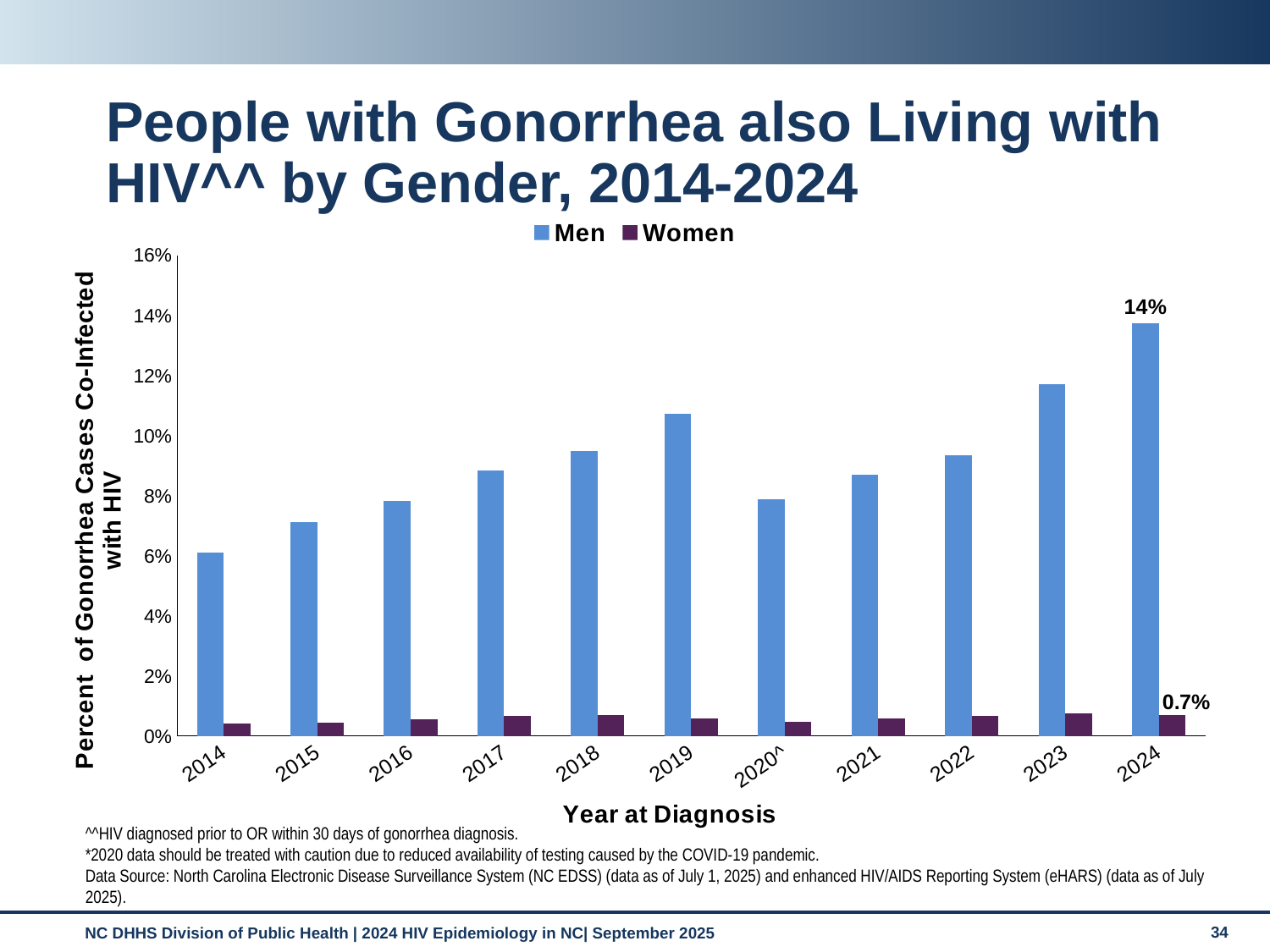
What is the difference between the Men and Women values in 2024? 13.3% How many years are shown on the x axis? 11 How many series does the legend list? 2 What percent of women with gonorrhea were co-infected with HIV in 2024? 0.7% Is the Men value for 2014 greater or less than 8%? less Is the Men value for 2023 greater or less than 10%? greater Do the Men values rise or fall from 2020^ to 2024? rise What percent of men with gonorrhea were co-infected with HIV in 2024? 14% Which year has a higher Men value, 2019 or 2020^? 2019 In which year is the Men bar highest? 2024 What kind of chart is shown on the slide? bar chart In which year is the Men bar lowest? 2014